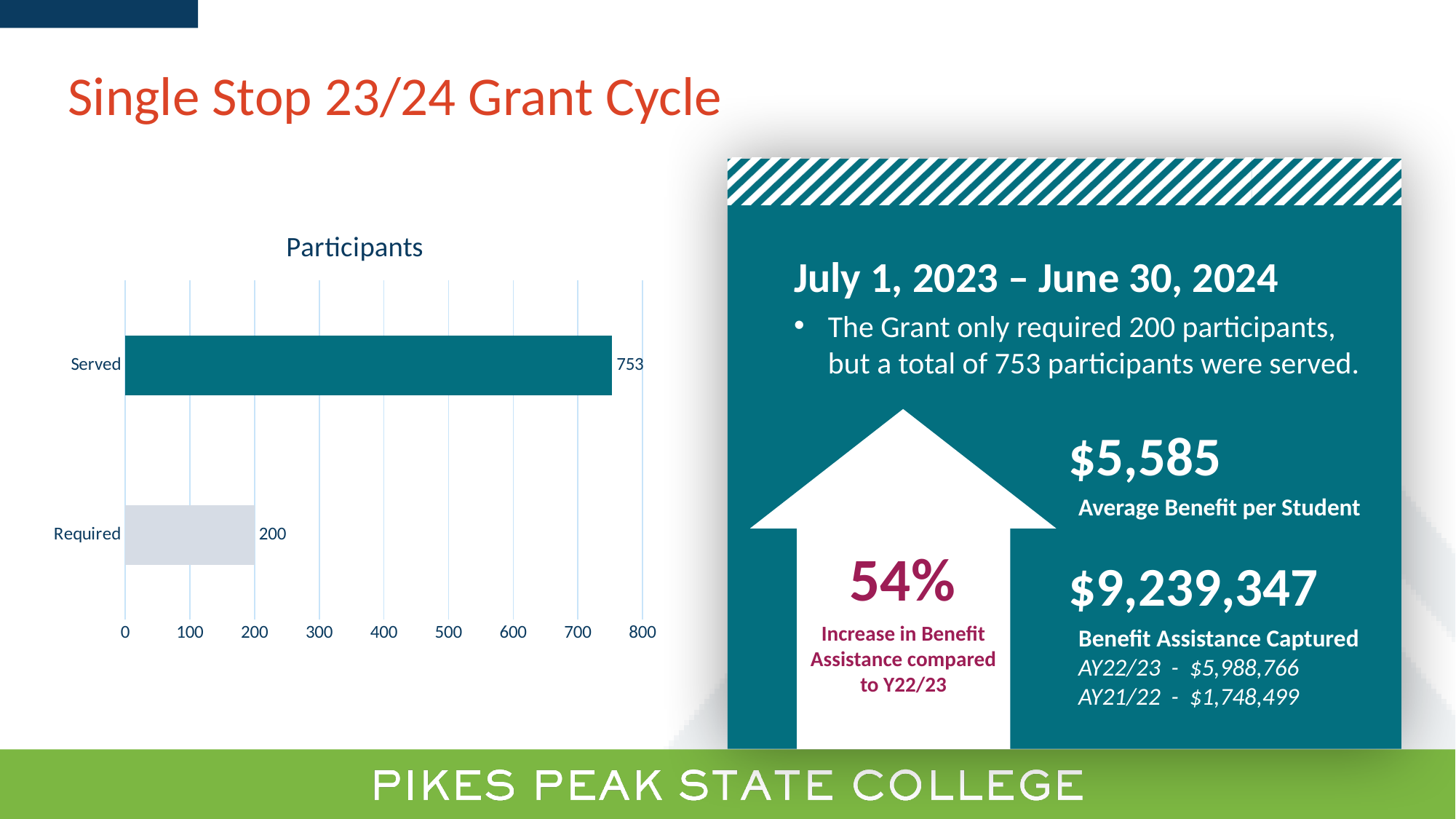
What is the value for Required in the Participants chart? 200 What is the highest value shown on the x axis of the Participants chart? 800 Which category has the lowest value in the Participants chart? Required Which is larger in the Participants chart, Served or Required? Served What is the title of the chart on the slide? Participants What is the value for Served in the Participants chart? 753 What kind of chart is the Participants chart? bar chart Is the value for Served greater or less than 700? greater Is the value for Required greater or less than 300? less Which category has the highest value in the Participants chart? Served How many categories are shown in the Participants chart? 2 What is the difference between the Served and Required values in the Participants chart? 553